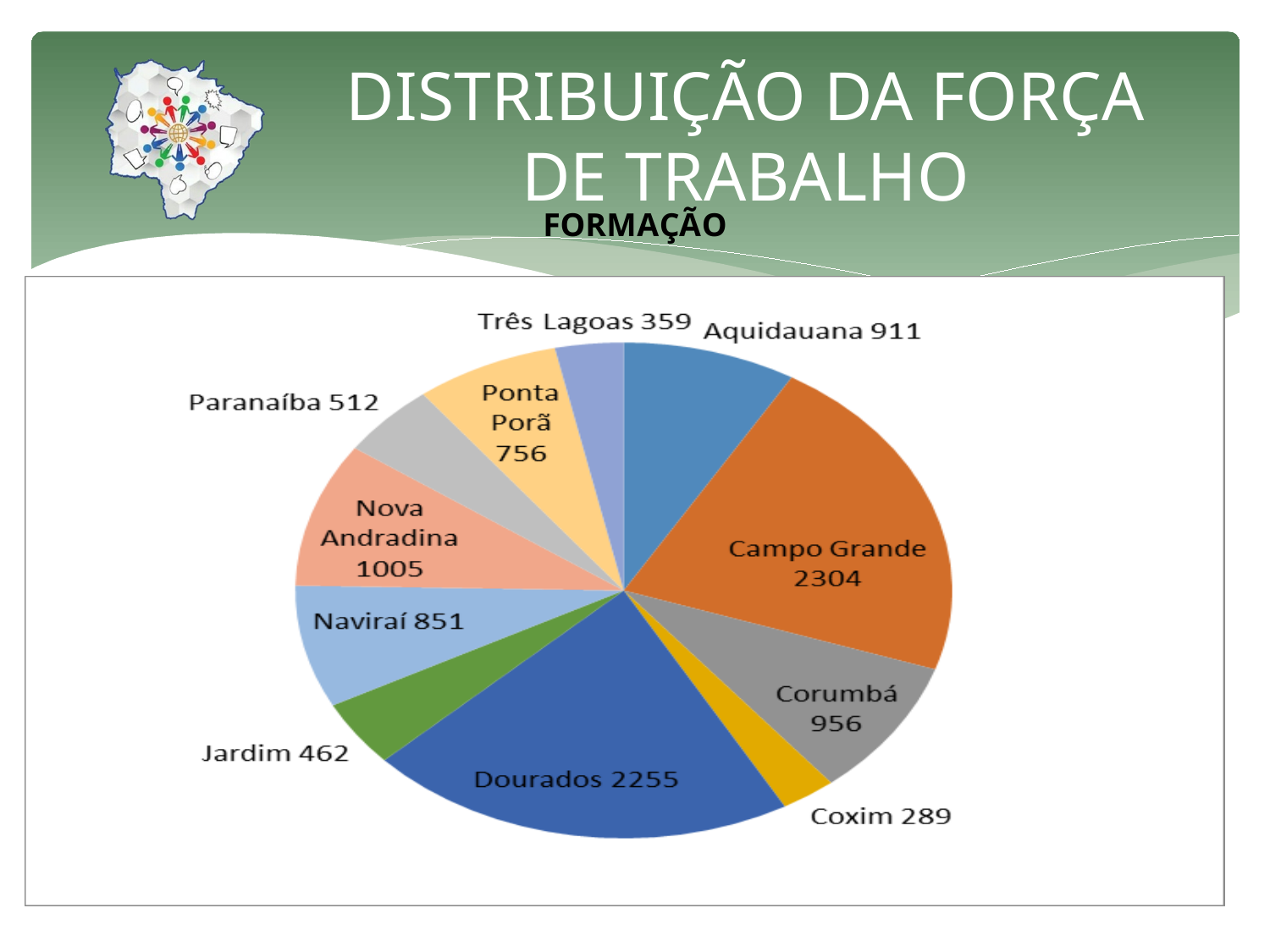
What type of chart is shown on the slide? Pie chart How many slices does the pie chart have? 11 Which is larger, the value for Paranaíba or the value for Jardim? Paranaíba Which is larger, the value for Corumbá or the value for Aquidauana? Corumbá Which category has the largest slice? Campo Grande What subtitle appears above the chart, below the main title? FORMAÇÃO What is the difference between the values for Campo Grande and Dourados? 49 Which category has the smallest slice? Coxim What is the value for Nova Andradina? 1005 What is the value for Campo Grande? 2304 What is the difference between the values for Nova Andradina and Naviraí? 154 What is the value for Três Lagoas? 359